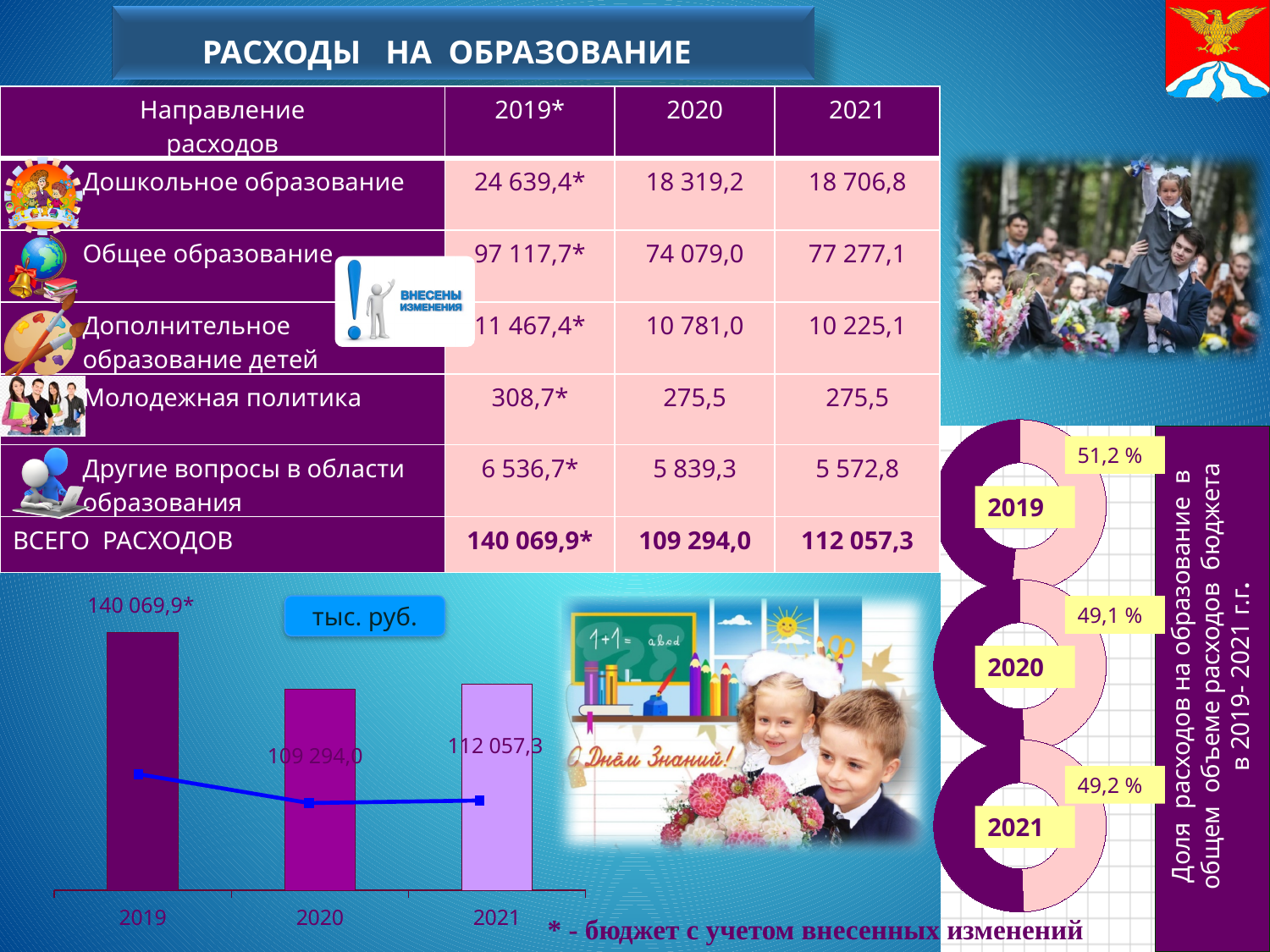
In the bar chart at the bottom left, what is the value shown for 2019? 140 069,9* What type of chart is shown at the bottom left of the slide? bar chart In the bar chart at the bottom left, what is the difference between the 2019 value and the 2020 value? 30 775,9 In the bar chart at the bottom left, which year has the lowest value? 2020 How many years (bars) are shown in the bar chart at the bottom left? 3 In the donut charts on the right, what share of total budget expenditure does education have in 2019? 51,2 % In the bar chart at the bottom left, what unit is indicated in the label box above the bars? тыс. руб. In the bar chart at the bottom left, what is the difference between the 2021 value and the 2020 value? 2 763,3 In the bar chart at the bottom left, which year has the highest value? 2019 In the bar chart at the bottom left, which is larger: the value for 2020 or the value for 2021? 2021 In the bar chart at the bottom left, what is the value shown for 2020? 109 294,0 In the bar chart at the bottom left, what is the value shown for 2021? 112 057,3